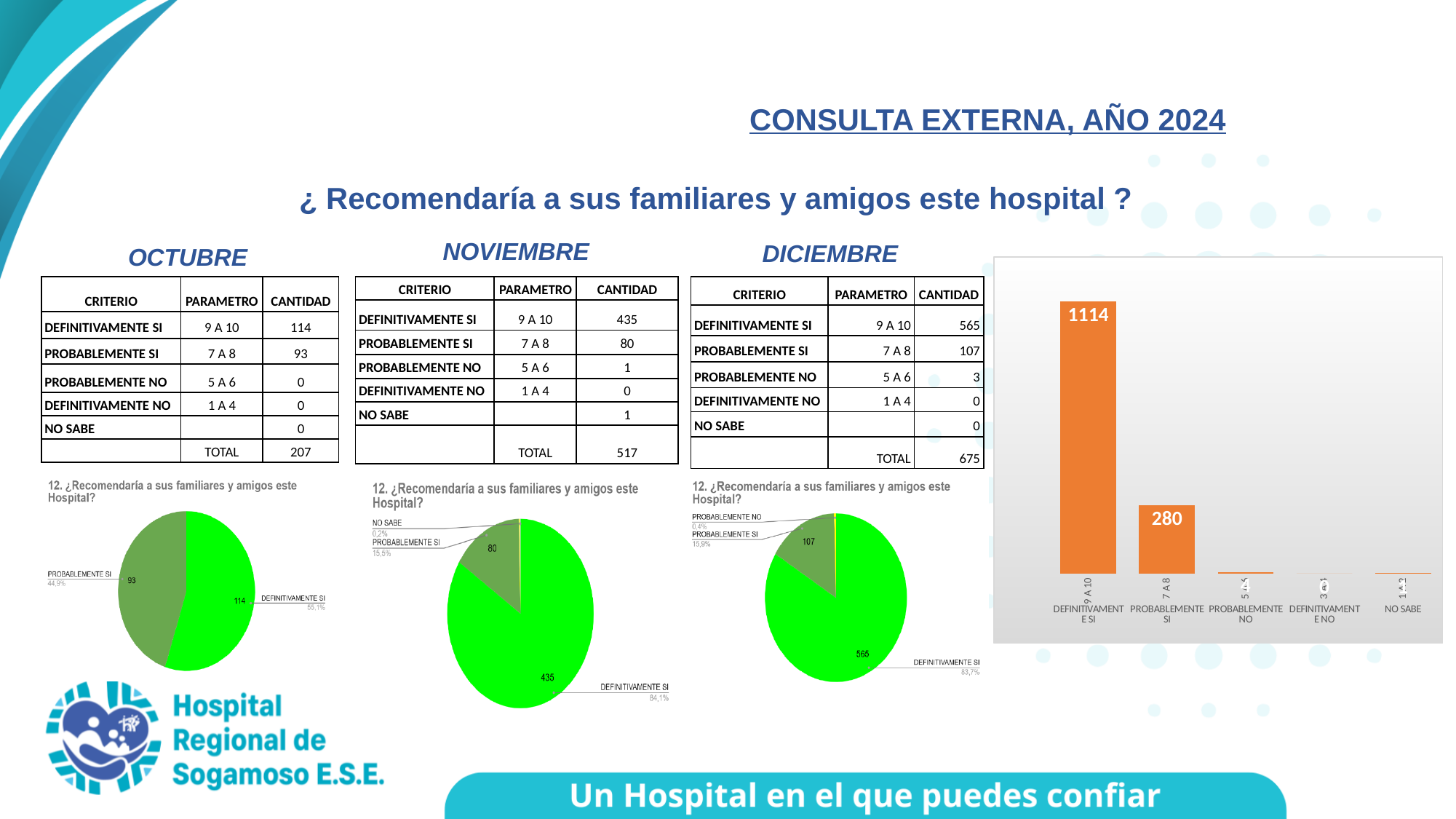
How many categories are shown in the orange bar chart on the right of the slide? 5 In the OCTUBRE pie chart, what value is shown for DEFINITIVAMENTE SI? 114 In the orange bar chart on the right of the slide, what is the difference between the DEFINITIVAMENTE SI and PROBABLEMENTE SI bars? 834 In the DICIEMBRE pie chart, what value is shown for DEFINITIVAMENTE SI? 565 In the orange bar chart on the right of the slide, which category has the highest value? DEFINITIVAMENTE SI In the OCTUBRE pie chart, what share of the pie does PROBABLEMENTE SI represent? 44,9% In the DICIEMBRE pie chart, which is larger, DEFINITIVAMENTE SI or PROBABLEMENTE SI? DEFINITIVAMENTE SI In the NOVIEMBRE pie chart, what share of the pie does DEFINITIVAMENTE SI represent? 84,1% In the orange bar chart on the right of the slide, what is the value for PROBABLEMENTE SI? 280 What type of chart is the orange chart on the right of the slide? bar chart In the orange bar chart on the right of the slide, what is the value for DEFINITIVAMENTE SI? 1114 In the NOVIEMBRE pie chart, what value is shown for PROBABLEMENTE SI? 80